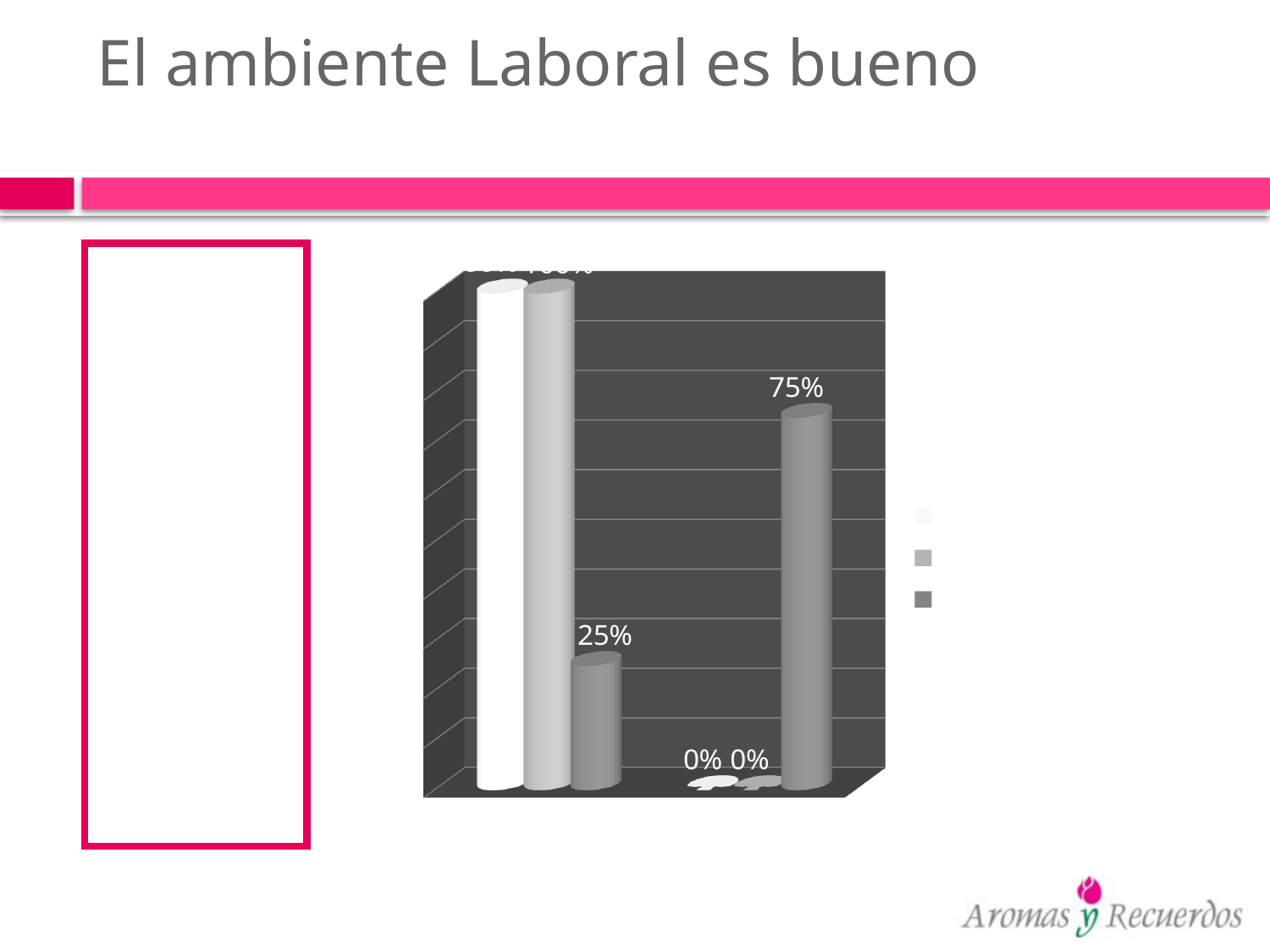
What is the title of the slide containing the chart? El ambiente Laboral es bueno What is the difference between the bar labelled 75% and the bar labelled 25%? 50% How many groups of bars (categories) are plotted in the chart? 2 What kind of chart is shown on the slide? bar chart Which is larger, the dark grey bar in the left-hand group or the dark grey bar in the right-hand group? the right-hand group What is the lowest value labelled in the chart? 0% How many series does the legend list? 3 What is the value of the shortest bar in the left-hand group? 25% How many bars in the chart are labelled 0%? 2 Is the value of the tallest bar in the right-hand group greater or less than 50%? greater What is the value of the tallest bar in the right-hand group? 75%